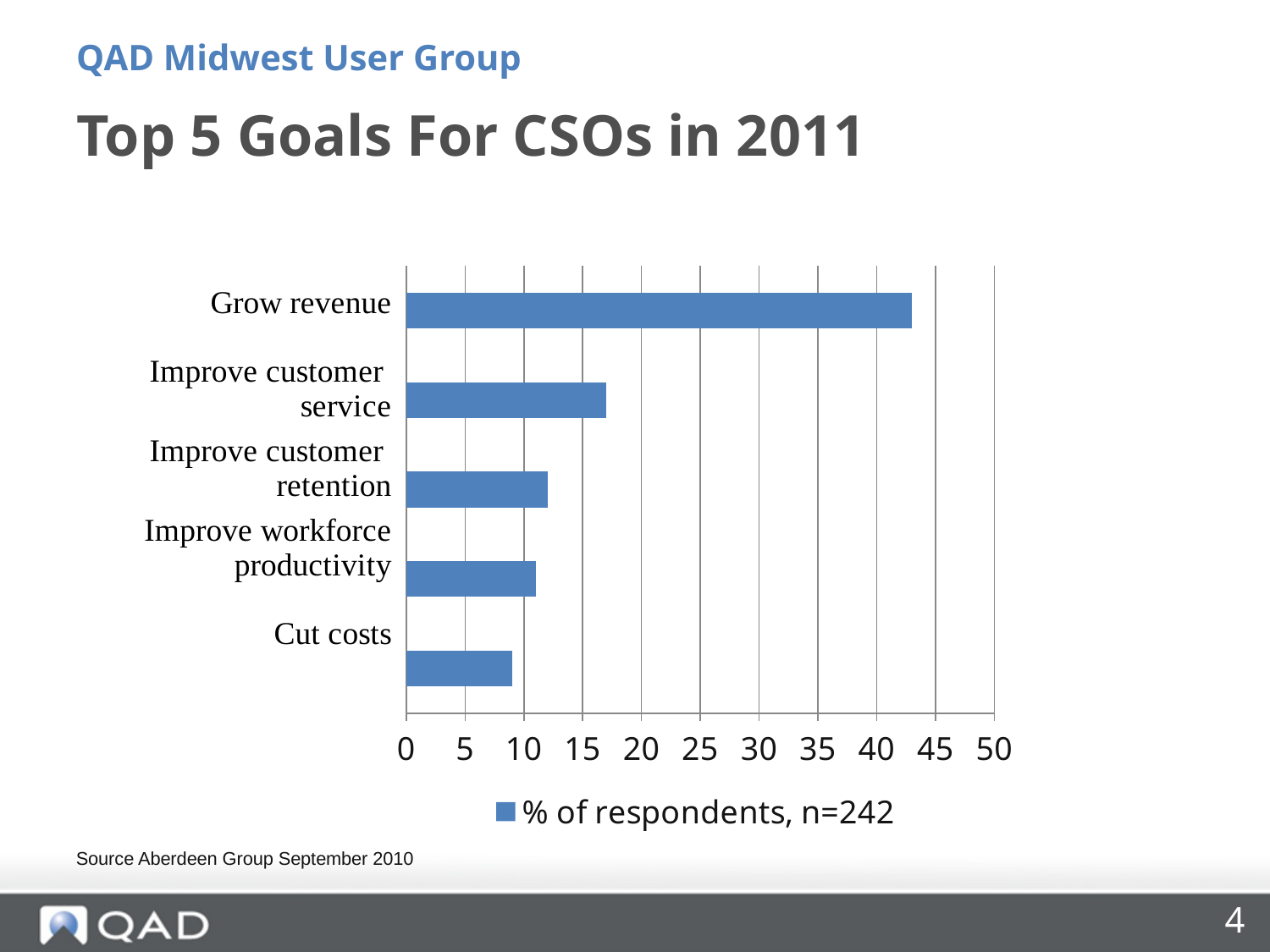
Is the value for Grow revenue greater or less than 40? greater What is the legend entry for the series shown in the chart? % of respondents, n=242 How many series does the chart legend list? 1 Is the value for Cut costs greater or less than 10? less What kind of chart is shown on the slide? bar chart Is the value for Improve customer service greater or less than 15? greater Which goal has the highest percentage of respondents? Grow revenue Which is larger, the value for Grow revenue or the value for Improve customer service? Grow revenue Which goal has the lowest percentage of respondents? Cut costs How many goals (categories) are plotted in the chart? 5 Which is larger, the value for Improve customer retention or the value for Cut costs? Improve customer retention